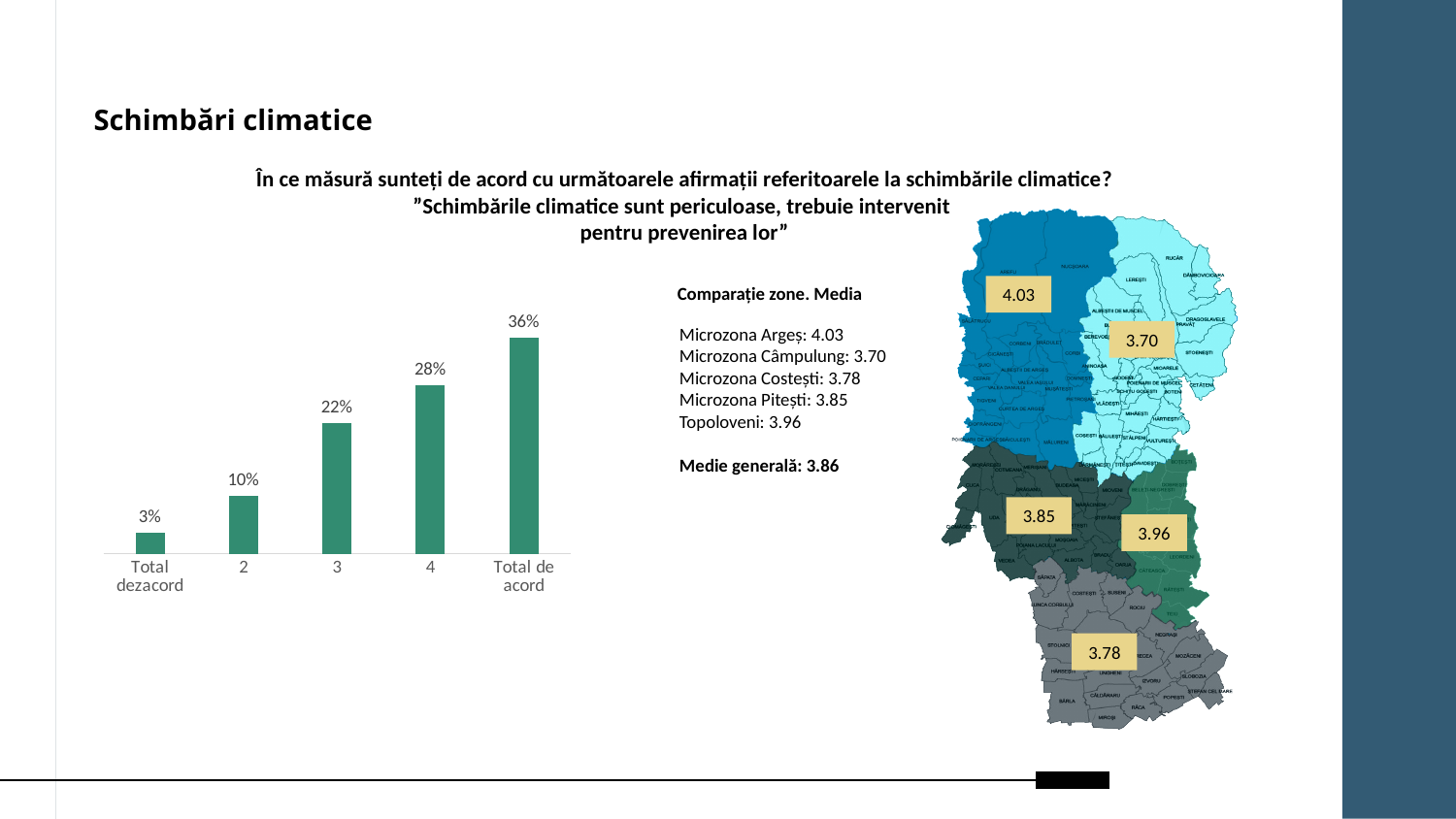
What percentage of respondents answered "Total dezacord"? 3% What percentage of respondents answered "Total de acord"? 36% Which is larger, the value for category 2 or the value for category 3? 3 Which category has the lowest value in the bar chart? Total dezacord What is the value shown for category 4? 28% What is the difference between the values for category 4 and category 3? 6% Which category has the highest value in the bar chart? Total de acord Do the values rise or fall from "Total dezacord" to "Total de acord" along the x axis? Rise What is the value shown for category 3? 22% What kind of chart is used to show the responses? Bar chart What is the difference between the values for "Total de acord" and "Total dezacord"? 33% How many categories are shown on the x axis of the bar chart? 5